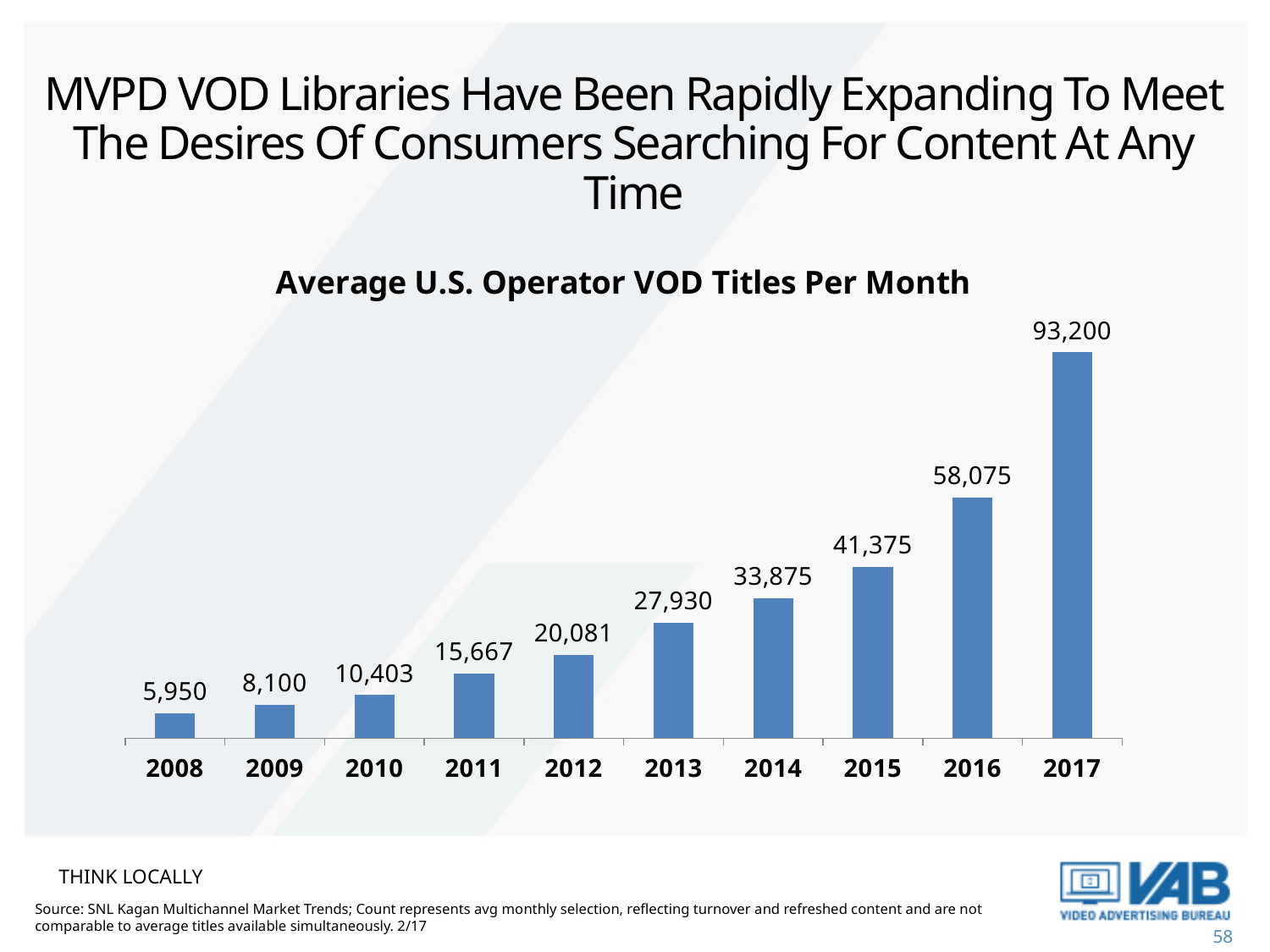
Which is larger, the value for 2013 or the value for 2011? 2013 Do the values rise or fall from 2008 to 2017? Rise How many years are shown on the x axis? 10 What is the value shown for 2008? 5,950 What kind of chart is shown on the slide? Bar chart What is the average U.S. operator VOD titles per month value for 2012? 20,081 What is the difference between the 2017 and 2016 values? 35,125 What is the difference between the 2015 and 2014 values? 7,500 Which year has the highest value? 2017 What is the title of the chart? Average U.S. Operator VOD Titles Per Month Which year has the lowest value? 2008 What is the value shown for 2017? 93,200